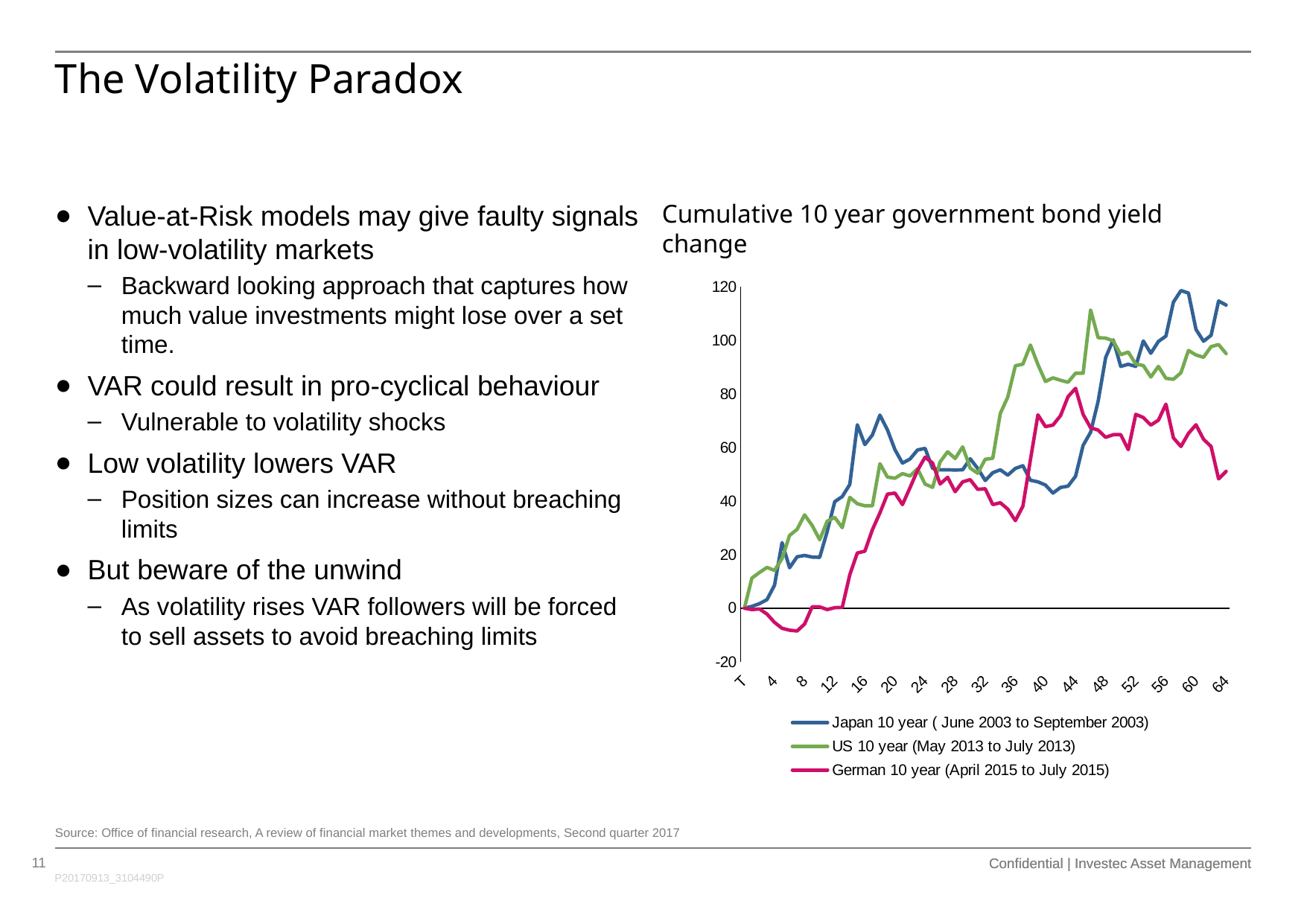
How many series does the legend list? 3 Is the value of the Japan 10 year series at point 64 greater or less than 100? greater Is the value of the German 10 year series at point 40 greater or less than 60? greater Is the value of the US 10 year series at point 36 greater or less than 80? greater Which series has the highest value at the last point (64) on the x axis? Japan 10 year ( June 2003 to September 2003) What kind of chart is shown on the slide? line chart At point 64, is the US 10 year series or the German 10 year series higher? US 10 year (May 2013 to July 2013) What is the title of the chart? Cumulative 10 year government bond yield change Which period does the legend give for the German 10 year series? April 2015 to July 2015 Which series has the lowest value at the last point (64) on the x axis? German 10 year (April 2015 to July 2015) Does the Japan 10 year series generally rise or fall from point 1 to point 64? rise